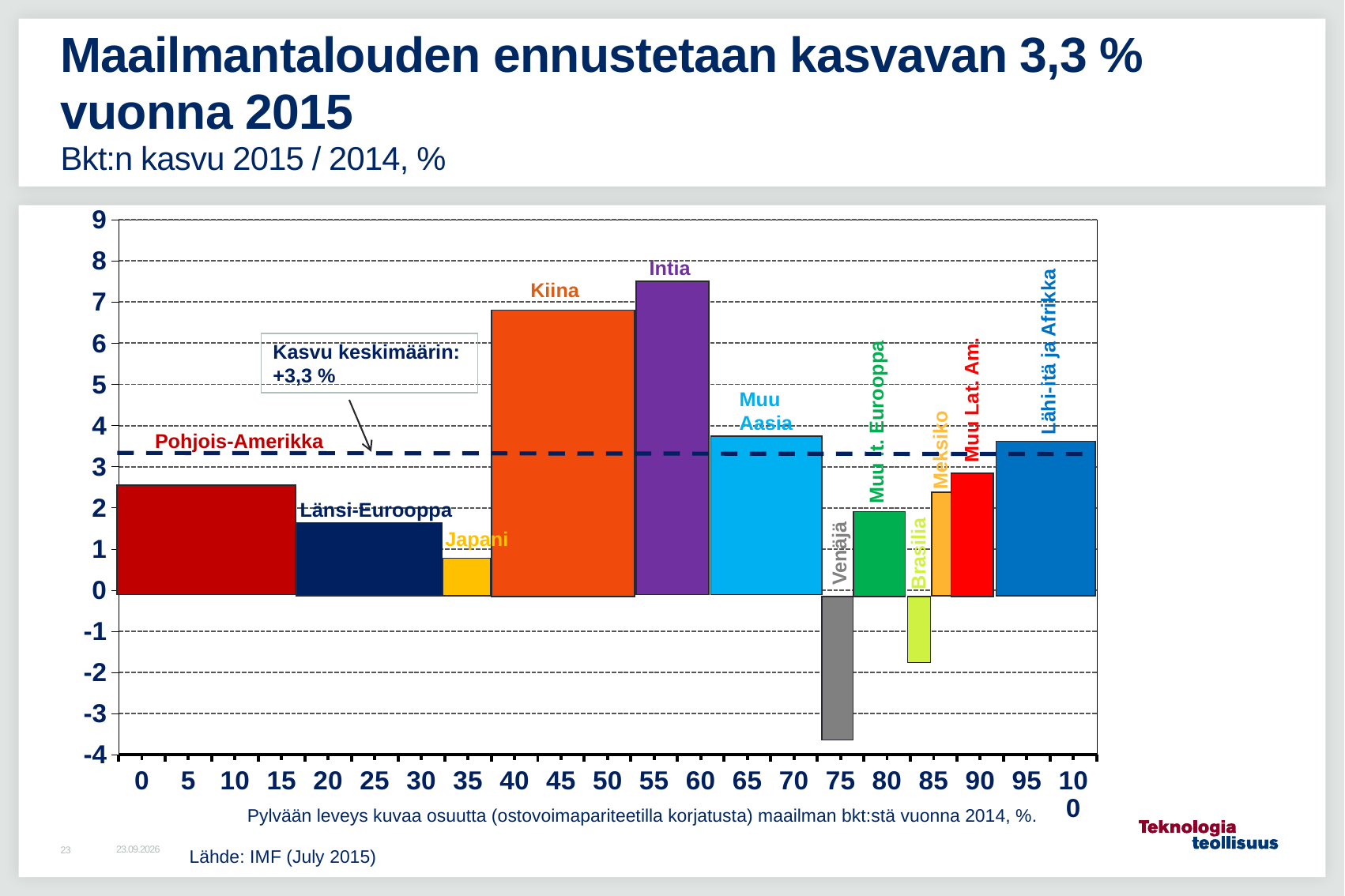
Which has higher growth, Japani or Länsi-Eurooppa? Länsi-Eurooppa Is the value for Pohjois-Amerikka greater or less than 3? less What average growth rate is marked by the dashed line in the chart? +3,3 % Which region has the highest GDP growth in the chart? Intia Is the value for Kiina greater or less than 6? greater Which has higher growth, Kiina or Intia? Intia Is the value for Muu Aasia greater or less than 3? greater How many regions (bars) are plotted in the chart? 12 What is the source of the data cited below the chart? IMF (July 2015) What kind of chart is shown on the slide? bar chart Which region has the lowest GDP growth in the chart? Venäjä